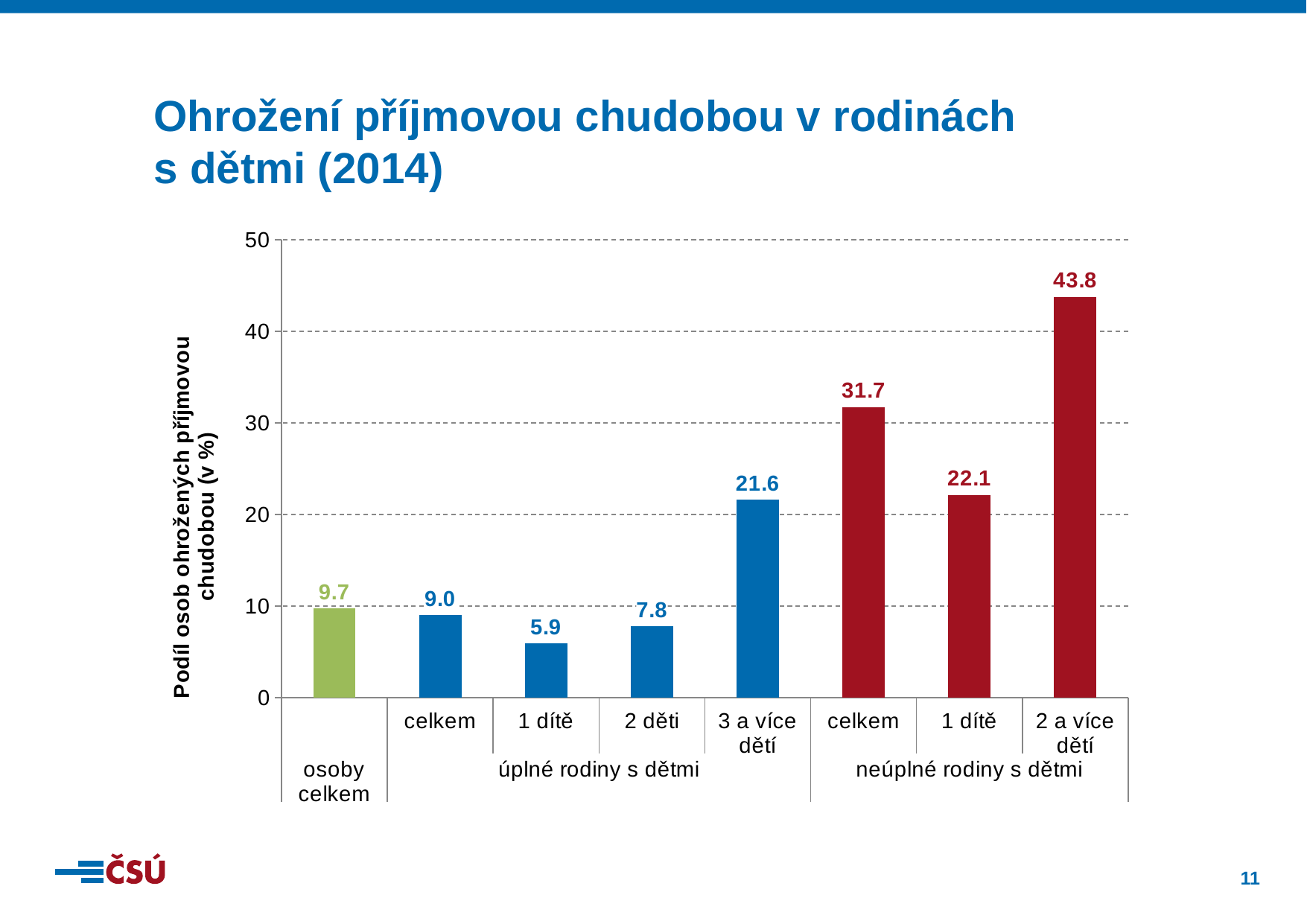
Which is larger: '1 dítě' in 'neúplné rodiny s dětmi' or '3 a více dětí' in 'úplné rodiny s dětmi'? 1 dítě (neúplné rodiny s dětmi) Which category has the highest value? 2 a více dětí (neúplné rodiny s dětmi) What is the difference between '2 a více dětí' in 'neúplné rodiny s dětmi' and '3 a více dětí' in 'úplné rodiny s dětmi'? 22.2 What is the value for 'celkem' in the 'neúplné rodiny s dětmi' group? 31.7 What is the value for '3 a více dětí' in the 'úplné rodiny s dětmi' group? 21.6 What is the value for 'osoby celkem'? 9.7 Which category has the lowest value? 1 dítě (úplné rodiny s dětmi) What is the difference between 'celkem' for 'neúplné rodiny s dětmi' and 'celkem' for 'úplné rodiny s dětmi'? 22.7 What is the y-axis label of the chart? Podíl osob ohrožených příjmovou chudobou (v %) What is the value for '1 dítě' in the 'úplné rodiny s dětmi' group? 5.9 How many bars are shown in the chart? 8 What kind of chart is shown on the slide? bar chart